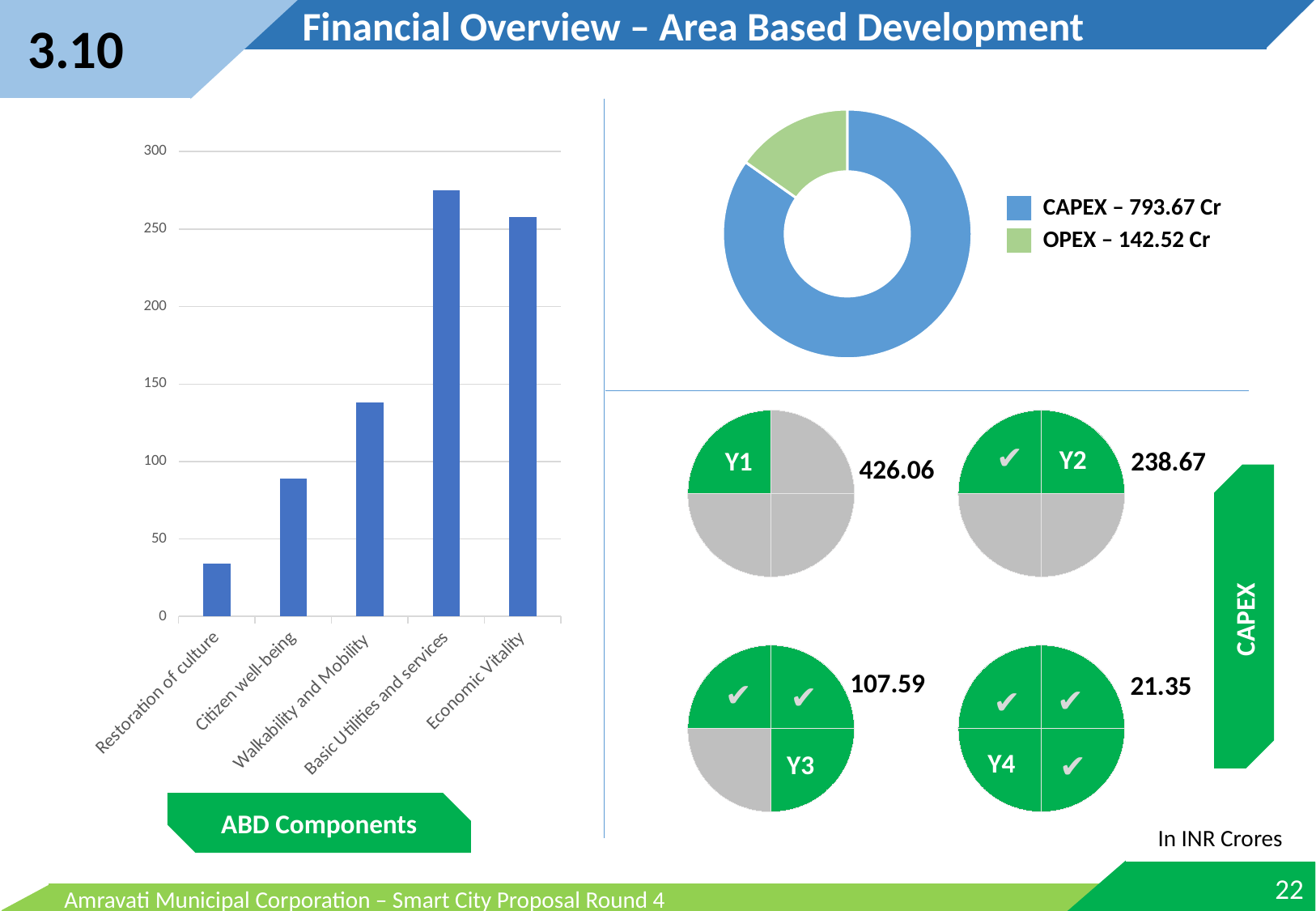
In the donut chart at the top right, what is the CAPEX value? 793.67 Cr How many categories does the ABD Components bar chart show? 5 In the ABD Components bar chart, which category has the lowest value? Restoration of culture In the donut chart at the top right, what is the difference between CAPEX and OPEX? 651.15 Cr In the ABD Components bar chart, is the value for Economic Vitality greater or less than 200? greater What kind of chart is the ABD Components chart on the left of the slide? bar chart In the ABD Components bar chart, is the value for Walkability and Mobility greater or less than 100? greater In the ABD Components bar chart, which category has the highest value? Basic Utilities and services How many entries does the legend of the donut chart at the top right list? 2 In the CAPEX year graphics at the bottom right, what is the value shown for Y4? 21.35 In the ABD Components bar chart, is the value for Restoration of culture greater or less than 50? less In the ABD Components bar chart, which is larger: Citizen well-being or Walkability and Mobility? Walkability and Mobility